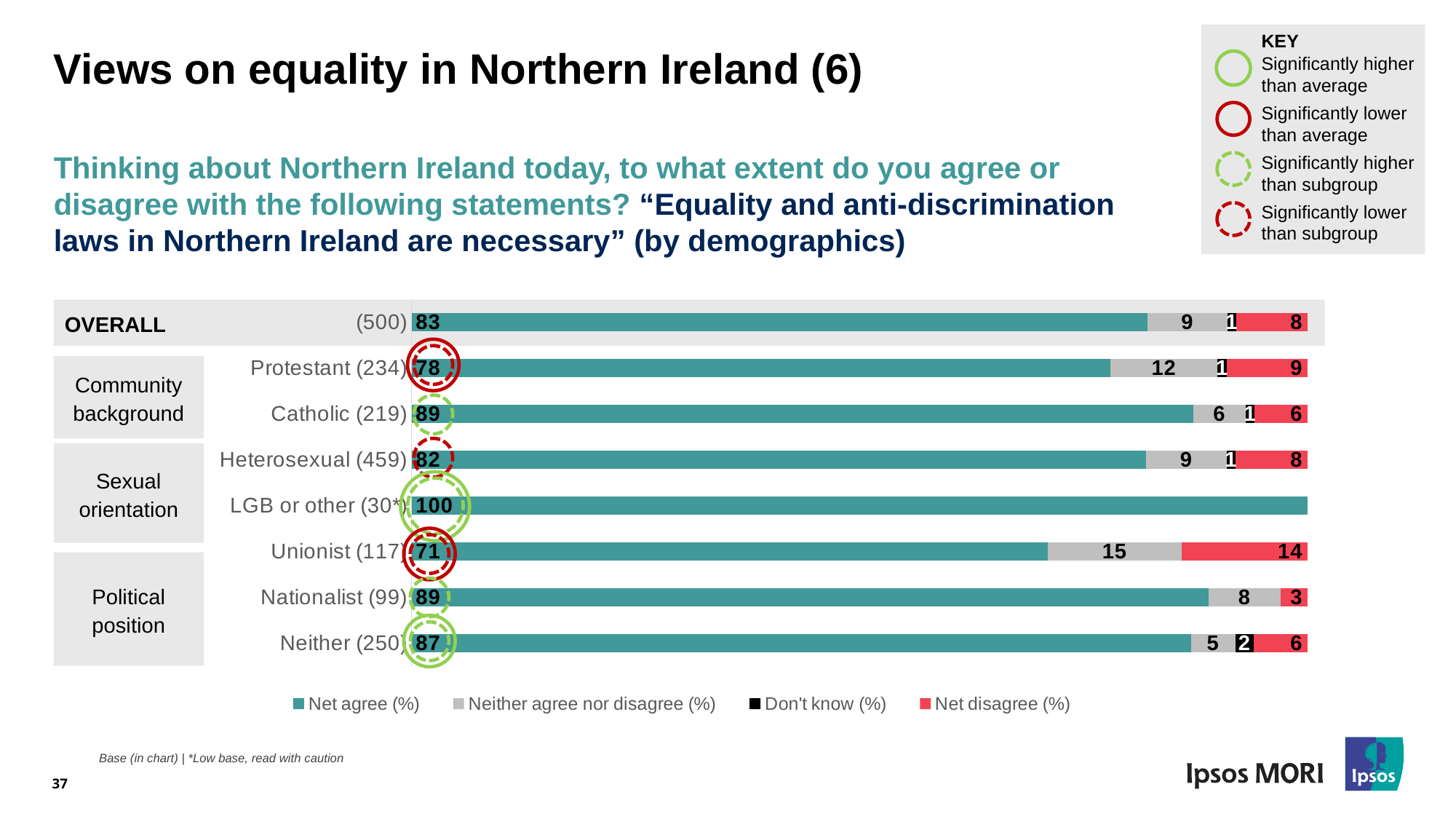
What is the Net disagree (%) value for Protestant (234)? 9 How many series does the legend list? 4 What is the Net agree (%) value for Unionist (117)? 71 Which category has the highest Net agree (%) value? LGB or other (30*) What is the difference in Net agree (%) between Catholic (219) and Protestant (234)? 11 What is the Don't know (%) value for Neither (250)? 2 How many demographic categories (bars) are shown in the chart, including OVERALL? 8 Which category has the lowest Net agree (%) value? Unionist (117) What kind of chart is shown on the slide? Stacked bar chart What is the Neither agree nor disagree (%) value for Catholic (219)? 6 Which has a larger Net disagree (%) value, Unionist (117) or Nationalist (99)? Unionist (117) Which series is shown in red in the legend? Net disagree (%)